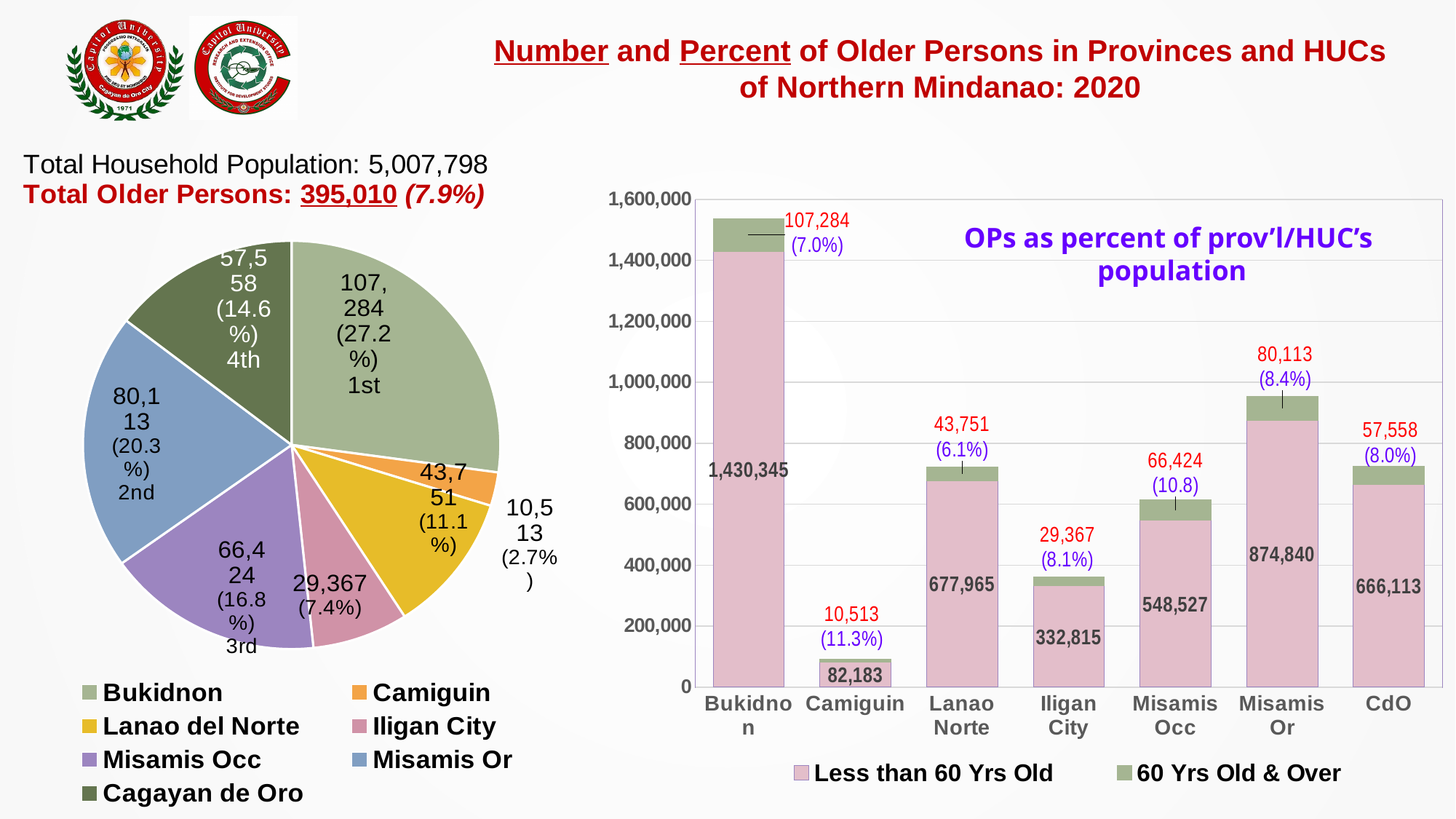
In the pie chart on the left, which province or HUC has the smallest slice? Camiguin In the pie chart on the left, which province or HUC has the largest slice? Bukidnon In the pie chart on the left, how many slices are there? 7 What kind of chart is shown on the right side of the slide? Stacked bar chart In the pie chart on the left, how many older persons are in Bukidnon? 107,284 In the bar chart on the right, what is the value for Less than 60 Yrs Old in Misamis Or? 874,840 In the bar chart on the right, what is the value for 60 Yrs Old & Over in Lanao Norte? 43,751 In the bar chart on the right, is the total for Misamis Occ greater or less than 800,000? less In the bar chart on the right, what is the difference between the Less than 60 Yrs Old values for CdO and Iligan City? 333,298 In the bar chart on the right, what is the total height of the stacked bar for Camiguin? 92,696 In the pie chart on the left, what share of older persons does Misamis Or account for? 20.3% In the bar chart on the right, how many series does the legend list? 2